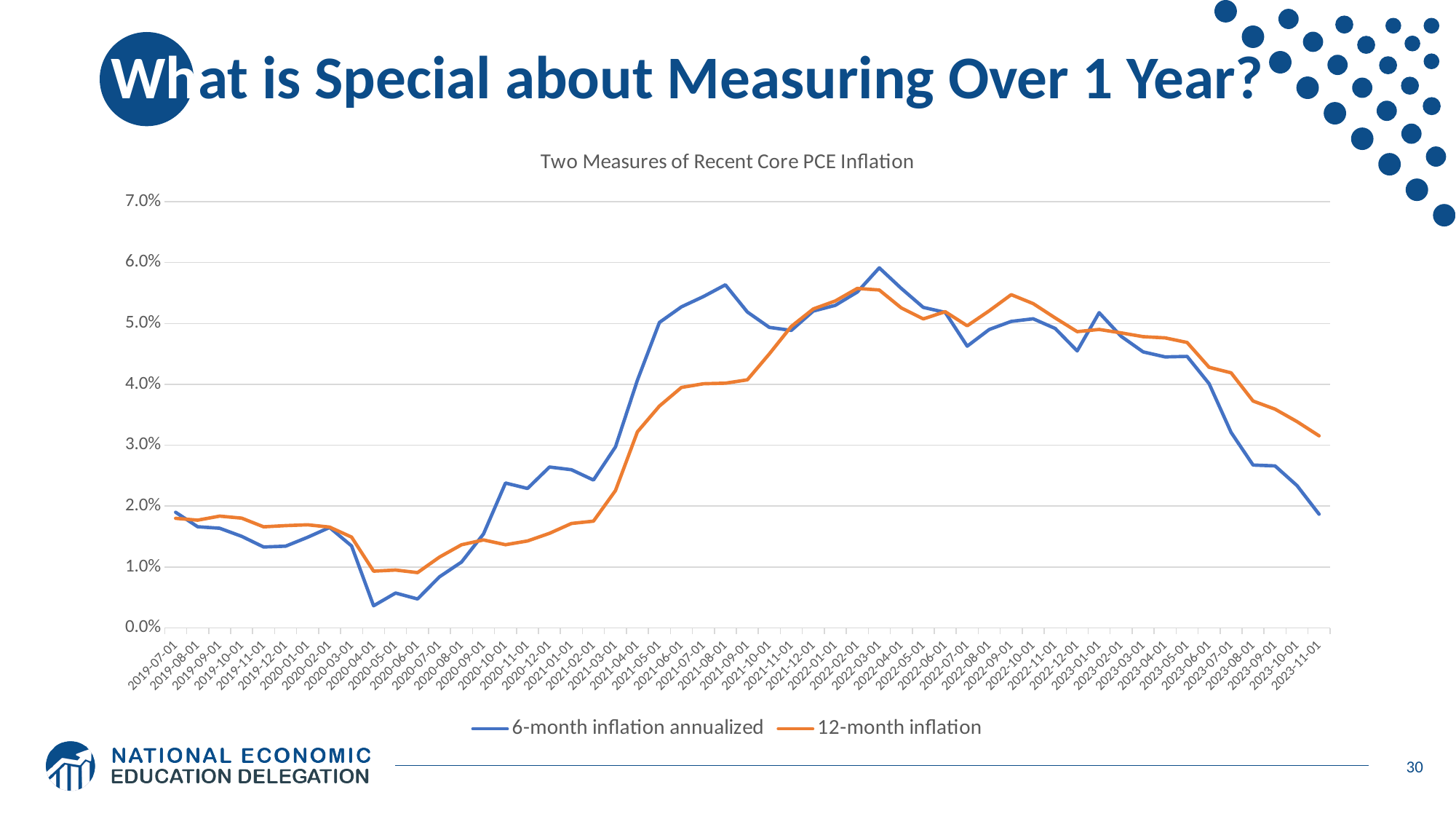
What is the title of the chart? Two Measures of Recent Core PCE Inflation Which colour is used for the 12-month inflation line? Orange Is the value of 12-month inflation at 2023-11-01 greater or less than 3.0%? greater How many series does the legend list? 2 Is the value of 6-month inflation annualized at 2023-11-01 greater or less than 2.0%? less What kind of chart is shown on the slide? Line chart Is the value of 6-month inflation annualized at 2020-04-01 greater or less than 1.0%? less At 2021-05-01, which series has the larger value, 6-month inflation annualized or 12-month inflation? 6-month inflation annualized At 2023-11-01, which series has the larger value, 6-month inflation annualized or 12-month inflation? 12-month inflation Does the 12-month inflation line rise or fall between 2022-09-01 and 2023-11-01? Fall How many monthly data points are plotted along the x axis? 53